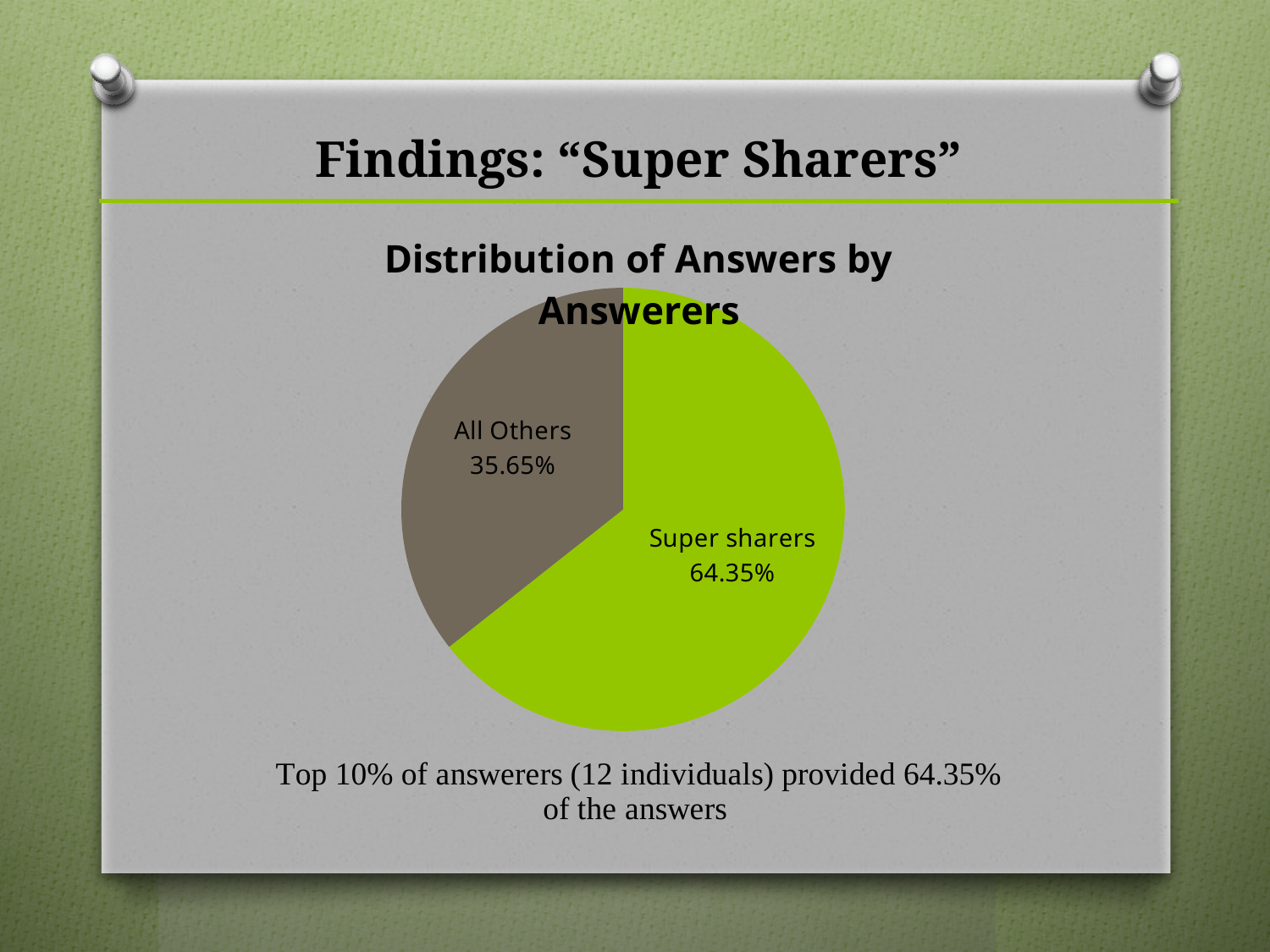
Is the share for All Others greater or less than 50%? less What is the total of the two slices shown in the pie chart? 100% How many slices does the pie chart have? 2 What is the title of the chart? Distribution of Answers by Answerers What share of the pie is labelled All Others? 35.65% What kind of chart is shown on the slide? Pie chart What share of the pie is labelled Super sharers? 64.35% Which is larger, the Super sharers slice or the All Others slice? Super sharers What is the difference in percentage points between the Super sharers slice and the All Others slice? 28.7 Which slice of the pie is the smallest? All Others Which slice of the pie is the largest? Super sharers What colour is the Super sharers slice? Green